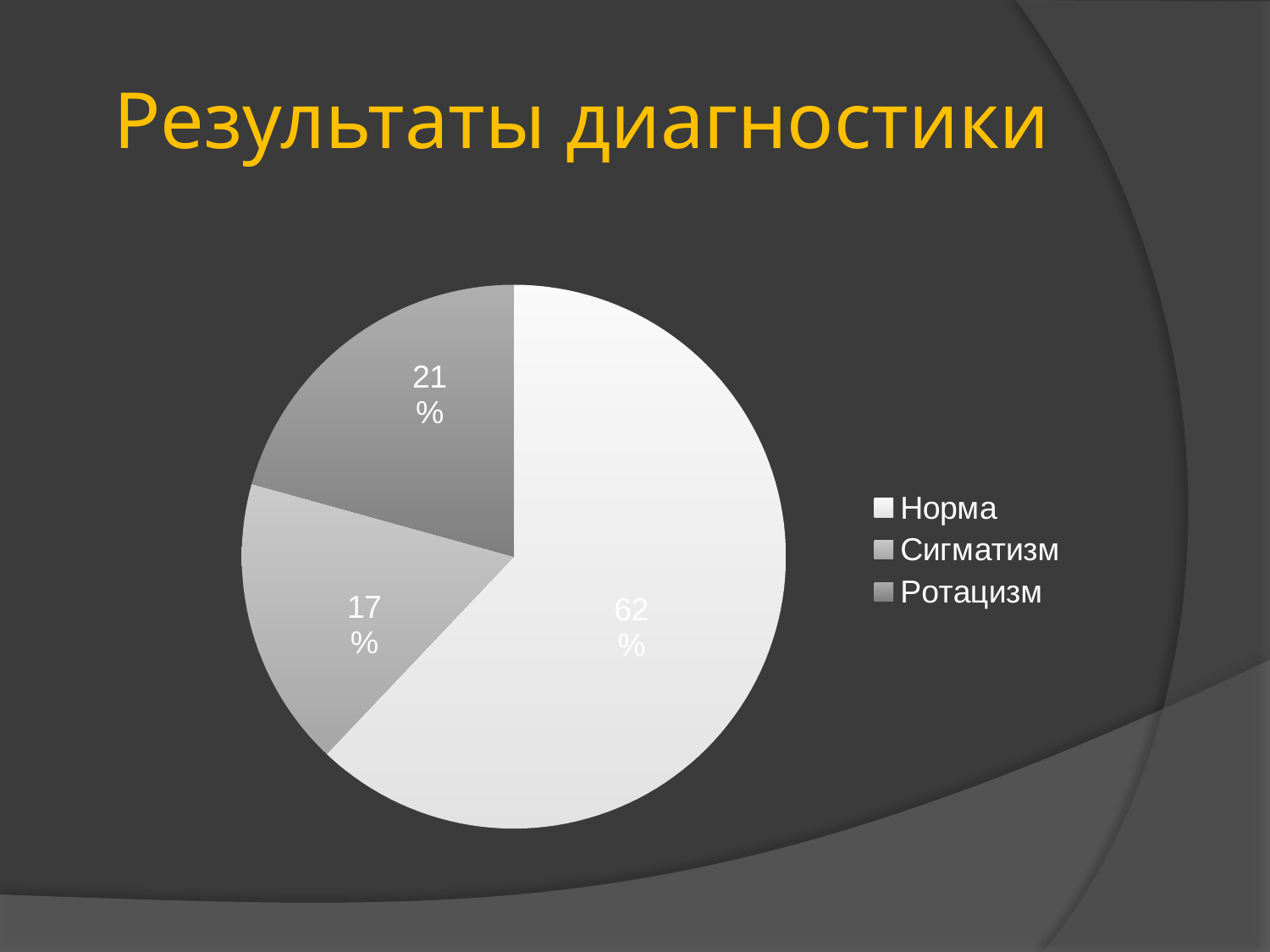
What share of the pie does Норма have? 62% How many entries does the legend list? 3 Which category has the largest slice of the pie? Норма What is the difference in percentage points between Ротацизм and Сигматизм? 4 What kind of chart is shown on the slide? pie chart Which is larger, the share for Ротацизм or the share for Сигматизм? Ротацизм How many slices does the pie chart have? 3 What is the difference in percentage points between Норма and Ротацизм? 41 What share of the pie does Ротацизм have? 21% What share of the pie does Сигматизм have? 17% What is the title of the slide containing the pie chart? Результаты диагностики Which category has the smallest slice of the pie? Сигматизм